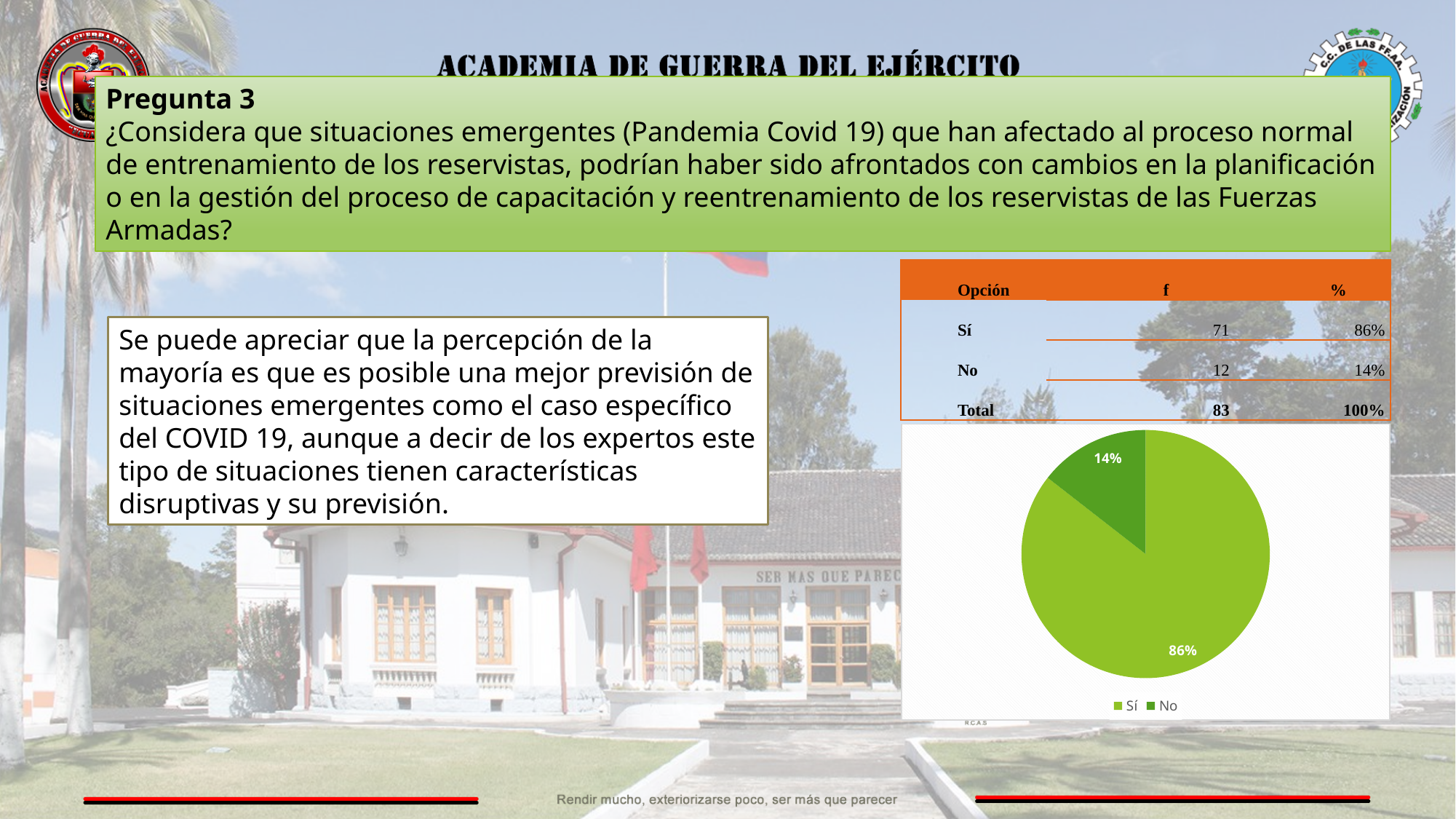
Which is larger in the pie chart, 'Sí' or 'No'? Sí What kind of chart is shown on the slide? pie chart Which slice of the pie chart is the largest? Sí What share of the pie does the 'Sí' slice represent? 86% How many slices does the pie chart have? 2 Which slice of the pie chart is shown in the darker green colour? No Is the share of the 'Sí' slice greater or less than 50%? greater What share of the pie does the 'No' slice represent? 14% What is the difference in percentage points between the 'Sí' and 'No' slices? 72 What are the two legend entries of the pie chart? Sí and No Which slice of the pie chart is the smallest? No How many entries does the legend of the pie chart list? 2